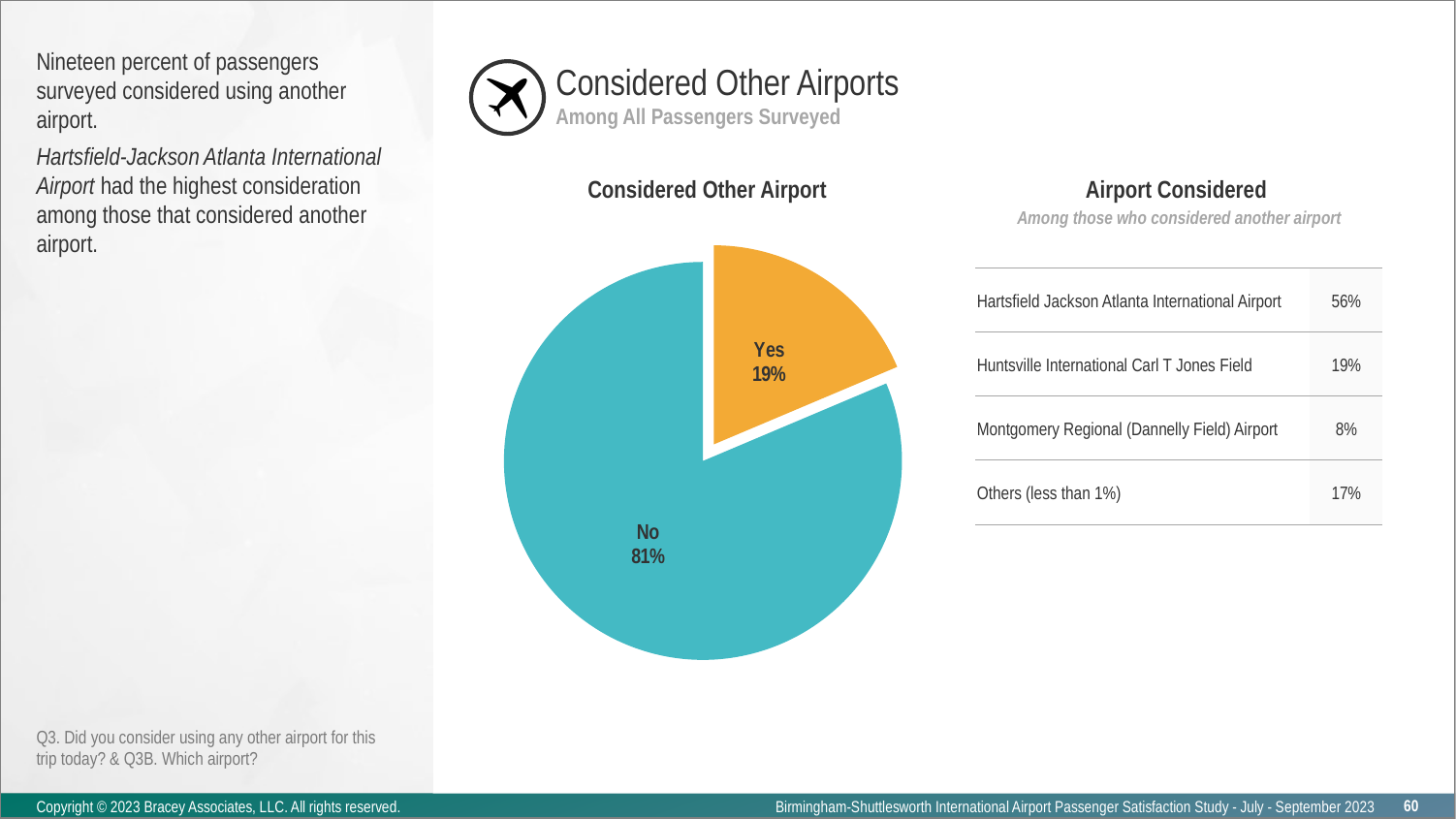
In the pie chart, what percentage of passengers answered Yes to considering another airport? 19% What type of chart is shown on the slide? Pie chart What share of the pie does the Yes slice represent? 19% Which slice of the pie chart is the largest? No What is the difference in percentage points between the No slice and the Yes slice? 62 Which is larger in the pie chart, the Yes slice or the No slice? No In the pie chart, what percentage of passengers answered No? 81% What do the Yes and No slices of the pie chart add up to? 100% Which slice of the pie chart is the smallest? Yes What is the title of the pie chart? Considered Other Airport How many slices does the pie chart have? 2 What colour is the Yes slice in the pie chart? Orange